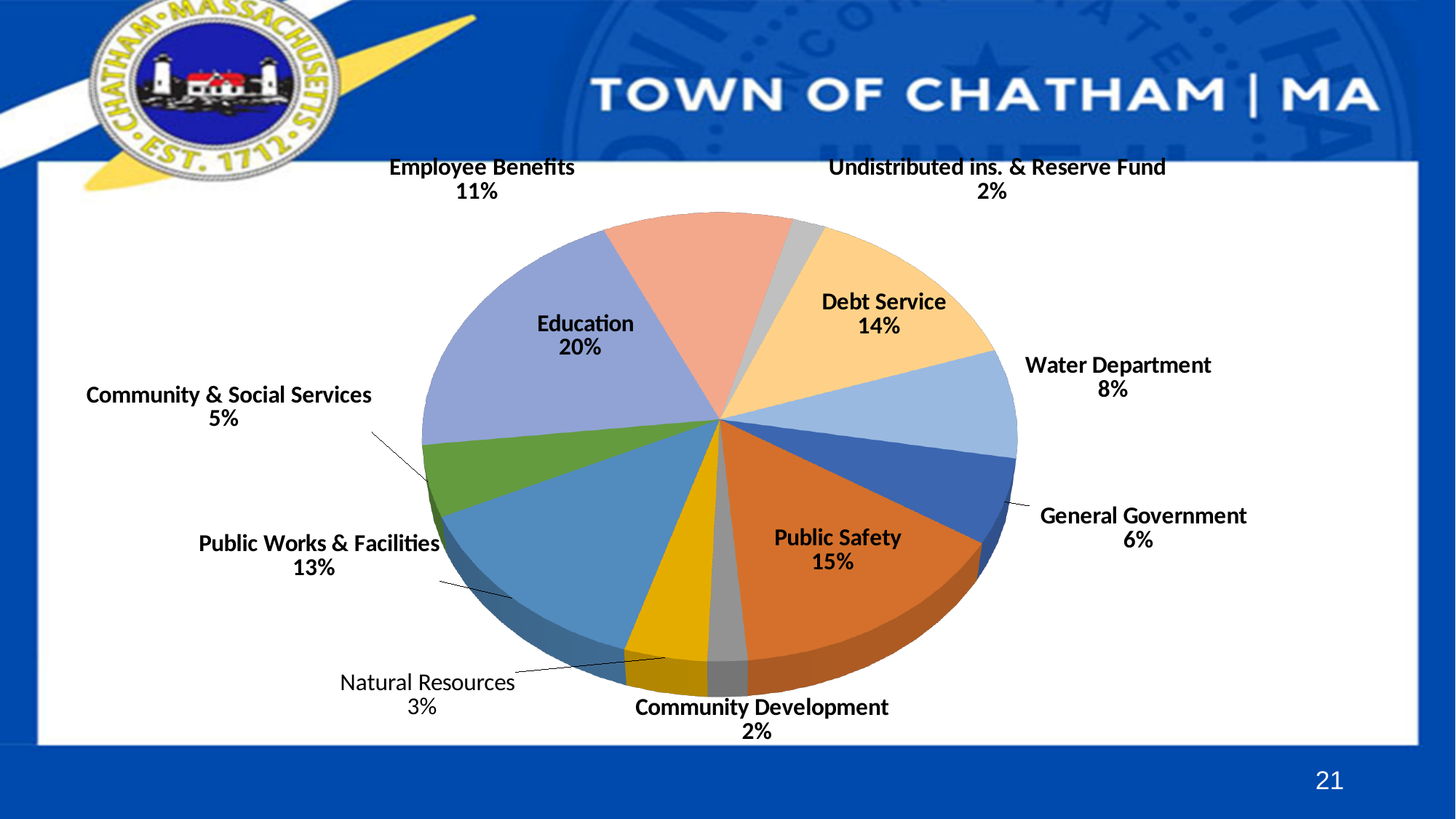
What is the value shown for Natural Resources? 3% How many slices does the pie chart have? 11 Which category has the largest slice of the pie? Education What share of the pie does Education represent? 20% What is the difference between the Education share and the Employee Benefits share? 9% What kind of chart is shown on the slide? Pie chart What is the difference between Public Safety and Debt Service? 1% What is the value shown for Public Safety? 15% What is the value shown for Undistributed ins. & Reserve Fund? 2% What is the value shown for Debt Service? 14% What is the value shown for Public Works & Facilities? 13% Which is larger, Water Department or General Government? Water Department